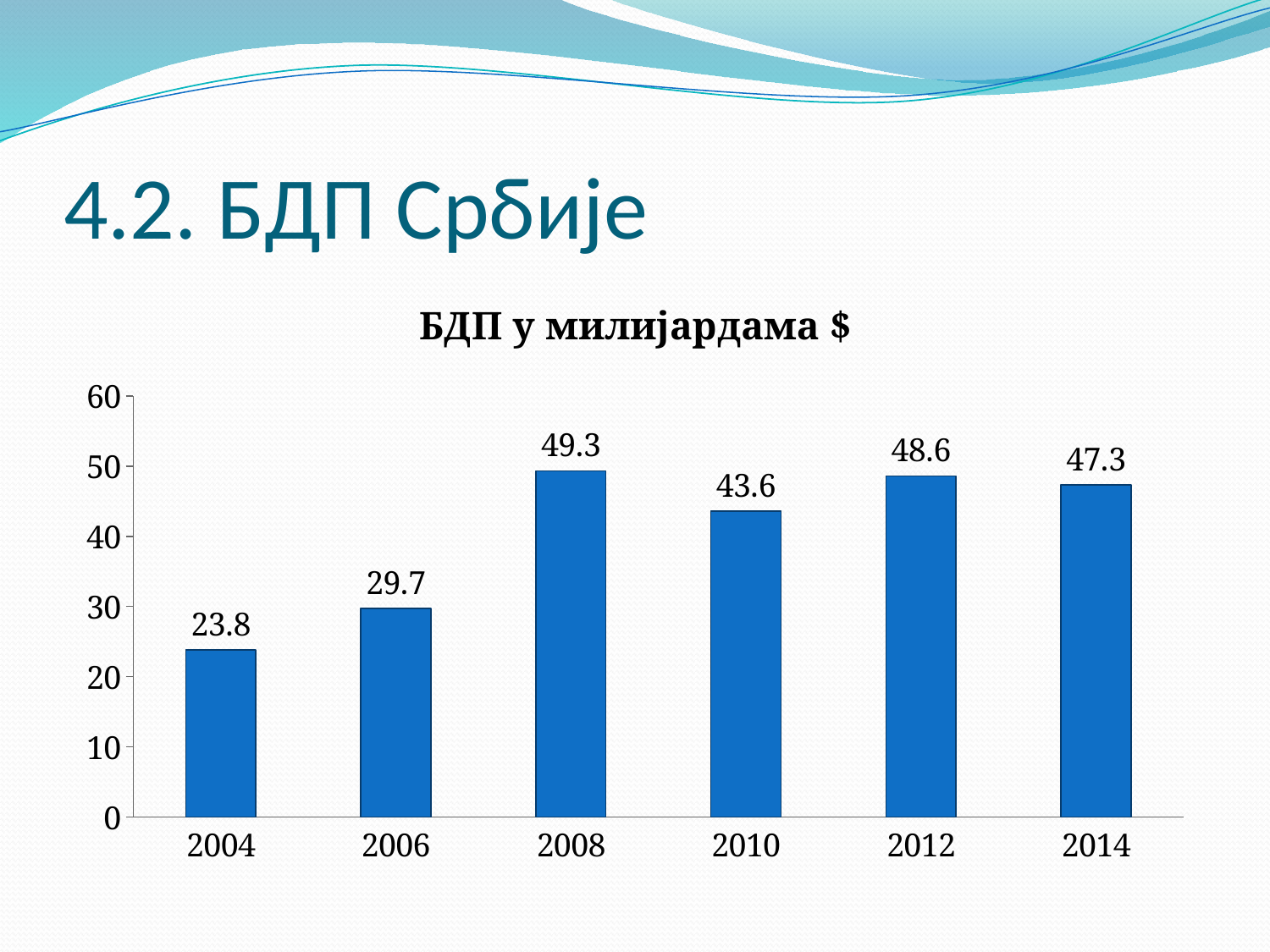
Which is larger, the value for 2006 or the value for 2010? 2010 What is the difference between the values for 2012 and 2010? 5 Which year has the lowest value? 2004 Is the value for 2006 greater or less than 30? less What kind of chart is shown on the slide? bar chart Which year has the highest value? 2008 What is the title of the chart? БДП у милијардама $ What is the value for 2004? 23.8 What is the value for 2014? 47.3 How many years are shown on the chart? 6 What is the value for 2010? 43.6 What is the difference between the values for 2008 and 2004? 25.5